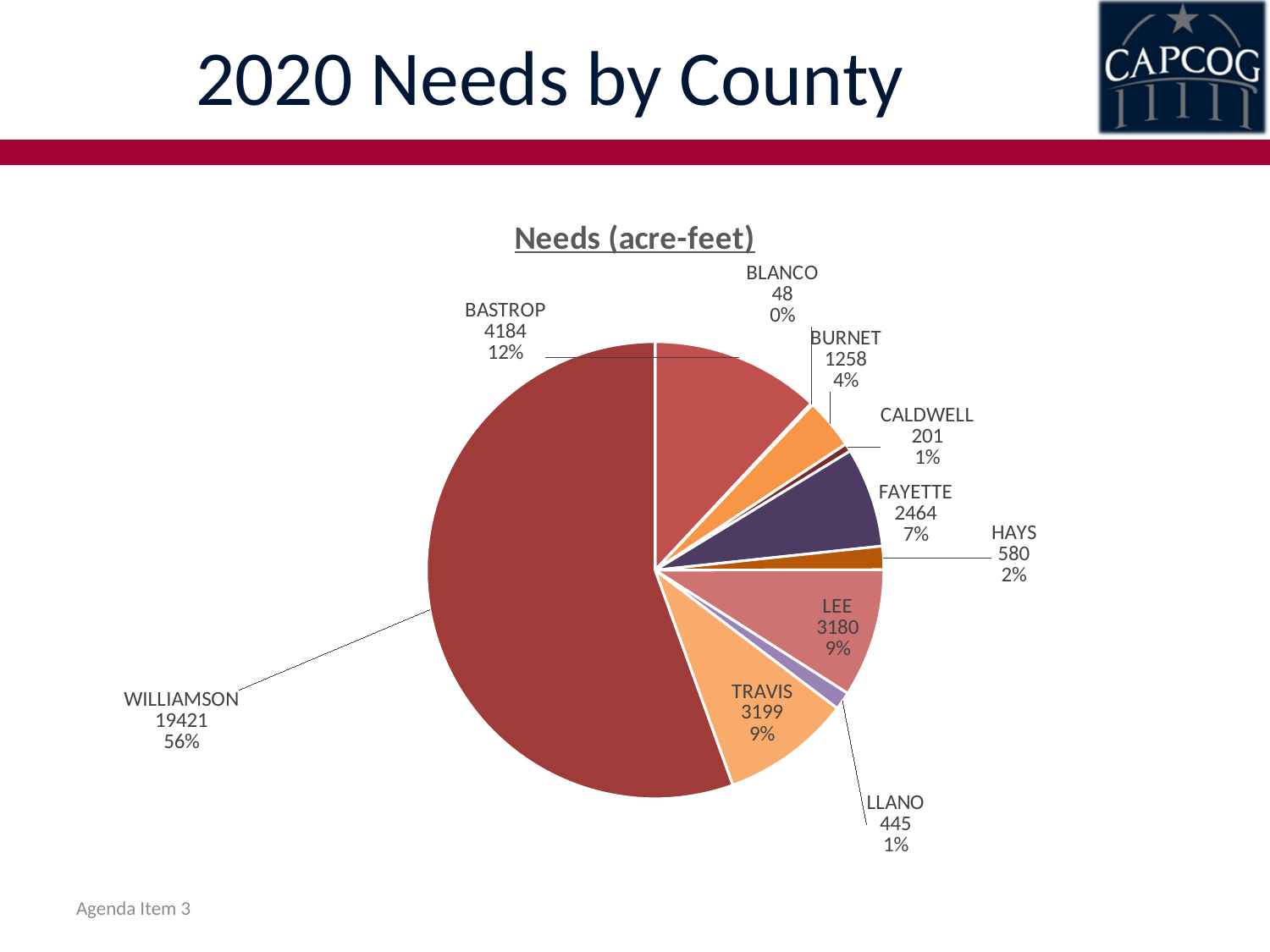
What is the difference between the values for Bastrop and Lee? 1004 What is the value for Williamson? 19421 What type of chart is shown on the slide? pie chart What share of the pie does Bastrop represent? 12% Which is larger, the value for Hays or the value for Llano? Hays Which county has the smallest share of the pie? Blanco Which county has the largest share of the pie? Williamson What is the value for Burnet? 1258 What is the chart's title? Needs (acre-feet) How many counties are shown in the pie chart? 10 What share of the pie does Lee represent? 9% What is the value for Fayette? 2464